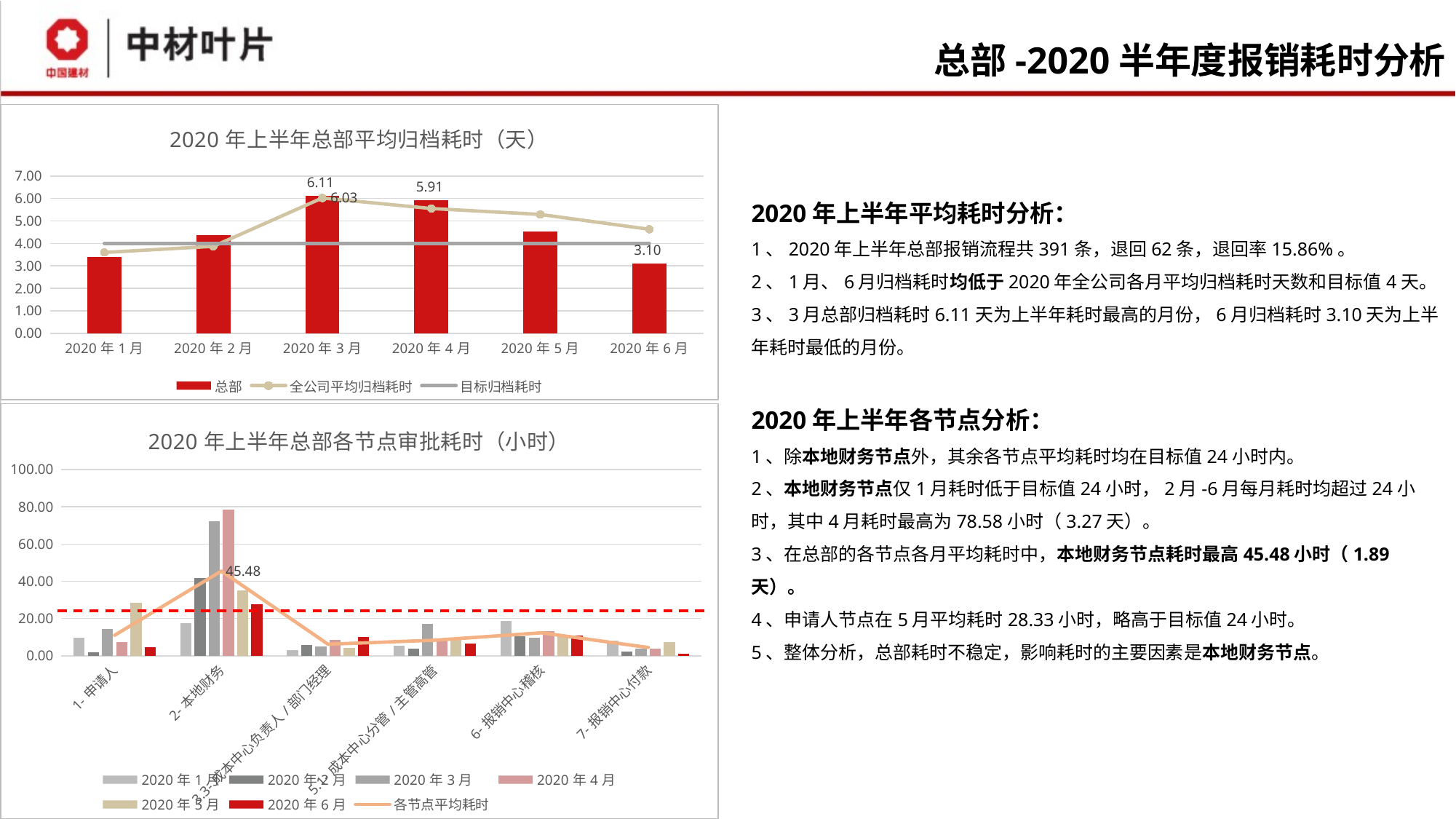
In the top chart (2020年上半年总部平均归档耗时), what is the difference between the 总部 values for 2020年3月 and 2020年6月? 3.01 In the top chart (2020年上半年总部平均归档耗时), which month has the highest 总部 value? 2020年3月 What type of chart is the top chart titled 2020年上半年总部平均归档耗时（天）? combination bar and line chart In the top chart (2020年上半年总部平均归档耗时), what is the 总部 value for 2020年3月? 6.11 How many series does the legend of the top chart (2020年上半年总部平均归档耗时) list? 3 In the top chart (2020年上半年总部平均归档耗时), what is the 全公司平均归档耗时 value for 2020年3月? 6.03 In the top chart (2020年上半年总部平均归档耗时), what is the 总部 value for 2020年6月? 3.10 How many node categories are shown on the x axis of the bottom chart (2020年上半年总部各节点审批耗时)? 6 In the top chart (2020年上半年总部平均归档耗时), what is the 总部 value for 2020年4月? 5.91 In the top chart (2020年上半年总部平均归档耗时), which month has the lowest 总部 value? 2020年6月 In the top chart (2020年上半年总部平均归档耗时), is the 总部 value for 2020年1月 greater or less than 4.00? less In the bottom chart (2020年上半年总部各节点审批耗时), what is the 各节点平均耗时 value for 2-本地财务? 45.48